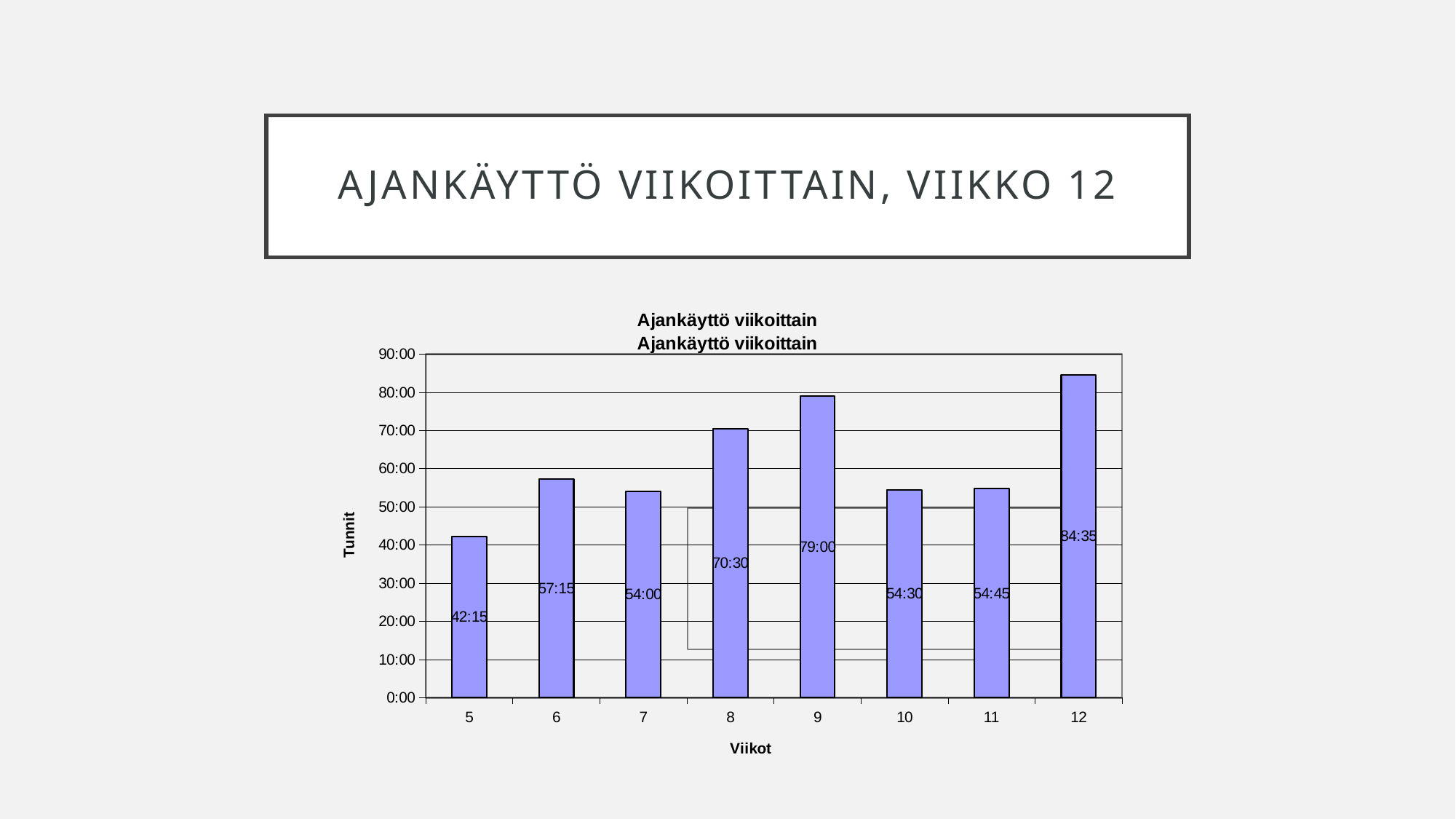
Which week has the lowest value? 5 Which week has the highest value? 12 Which is larger, the value for week 8 or the value for week 9? week 9 How many weeks are shown on the x axis? 8 What kind of chart is shown on the slide? bar chart Is the value for week 12 greater or less than 80:00? greater What is the value for week 5? 42:15 What is the difference between the values for week 9 and week 8? 8:30 What is the value for week 9? 79:00 What is the difference between the values for week 12 and week 5? 42:20 What is the label of the y axis? Tunnit What is the value for week 11? 54:45